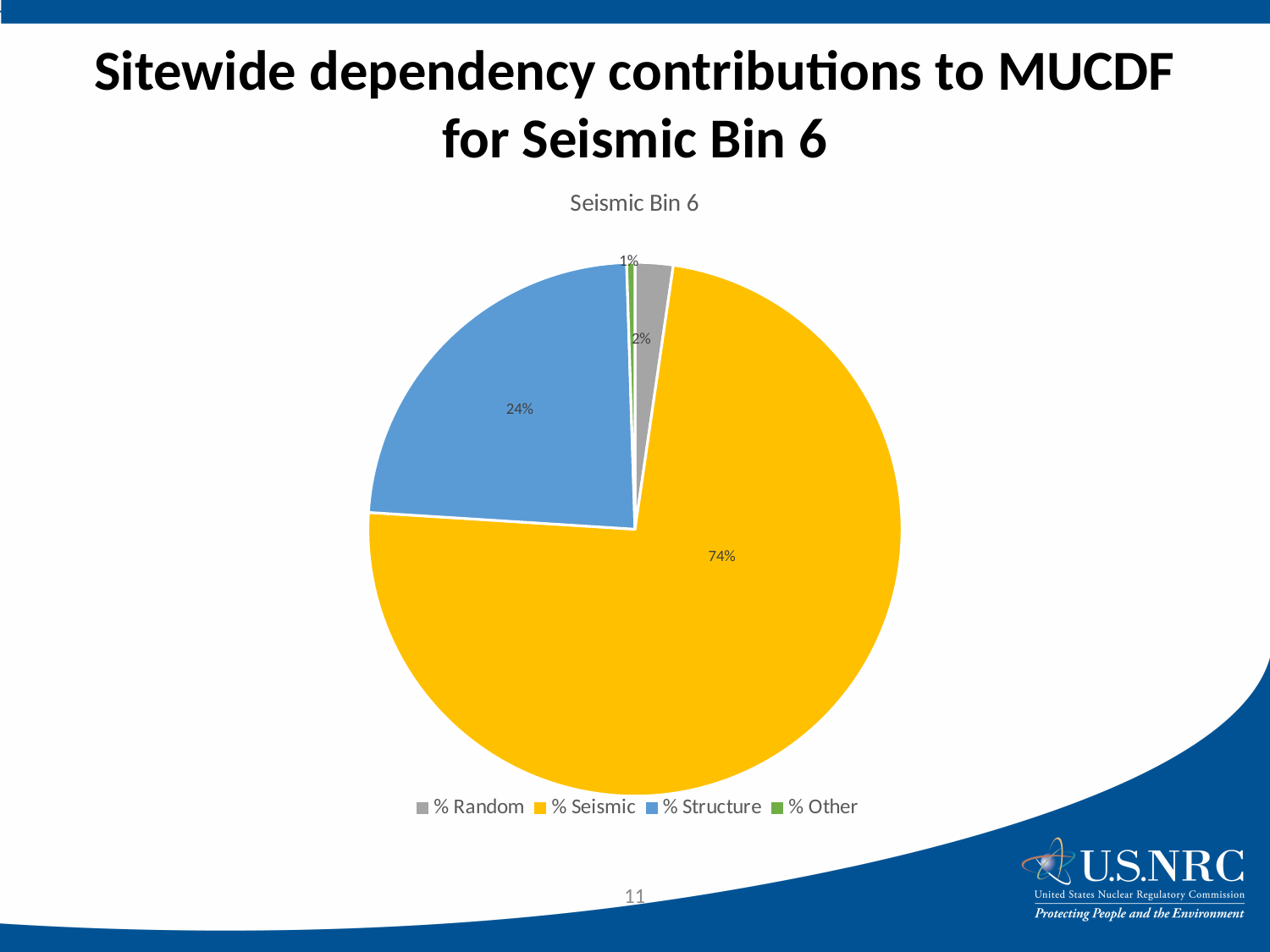
What is the chart's title? Seismic Bin 6 Which is larger, the % Structure slice or the % Random slice? % Structure What colour is the % Seismic slice? yellow What share of the pie does % Other take? 1% What share of the pie does % Random take? 2% What share of the pie does % Seismic take? 74% Which category has the largest slice of the pie? % Seismic What is the difference between the % Seismic and % Structure shares? 50% What kind of chart is shown on the slide? pie chart Which category has the smallest slice of the pie? % Other How many categories does the legend list? 4